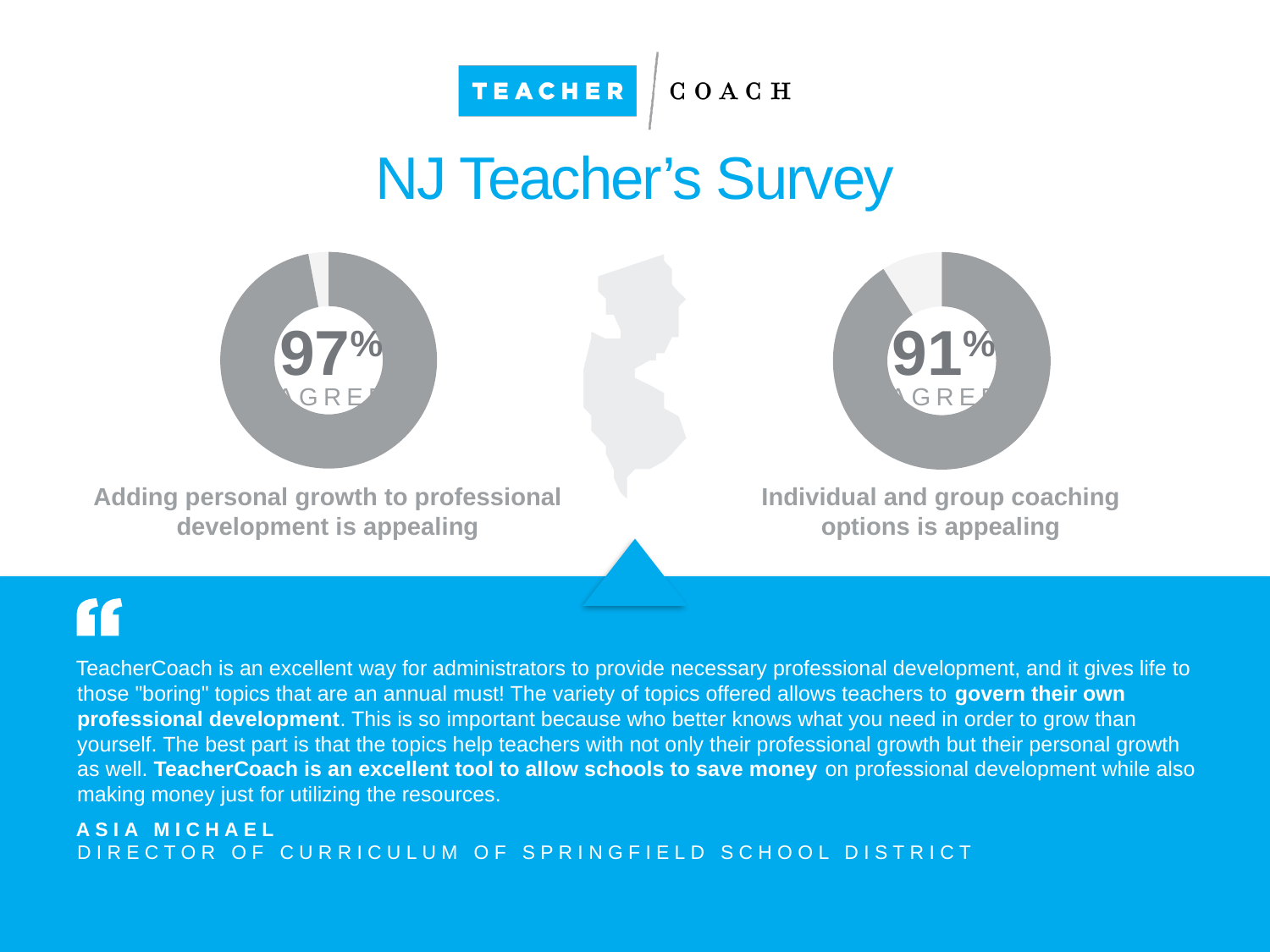
On the left donut chart, what percentage agree that adding personal growth to professional development is appealing? 97% What kind of chart is used to show the 97% and 91% figures on the slide? Donut (pie) chart What is the title of the survey shown above the donut charts? NJ Teacher's Survey On the right donut chart, what share of the ring is not shaded dark grey (the remainder after 91%)? 9% Which of the two donut charts shows the higher percentage, the left one (personal growth) or the right one (coaching options)? The left one (personal growth), 97% On the right donut chart, what percentage agree that individual and group coaching options is appealing? 91% Which statement has the lowest agreement percentage on the slide? Individual and group coaching options is appealing (91%) On the left donut chart, what share of the ring is not shaded dark grey (the remainder after 97%)? 3% What word appears below the percentage inside each donut chart? AGREE Is the value shown on the right donut chart greater or less than 95%? less What is the difference between the percentage shown on the left donut chart and the percentage shown on the right donut chart? 6 percentage points How many donut charts are shown on the slide? 2